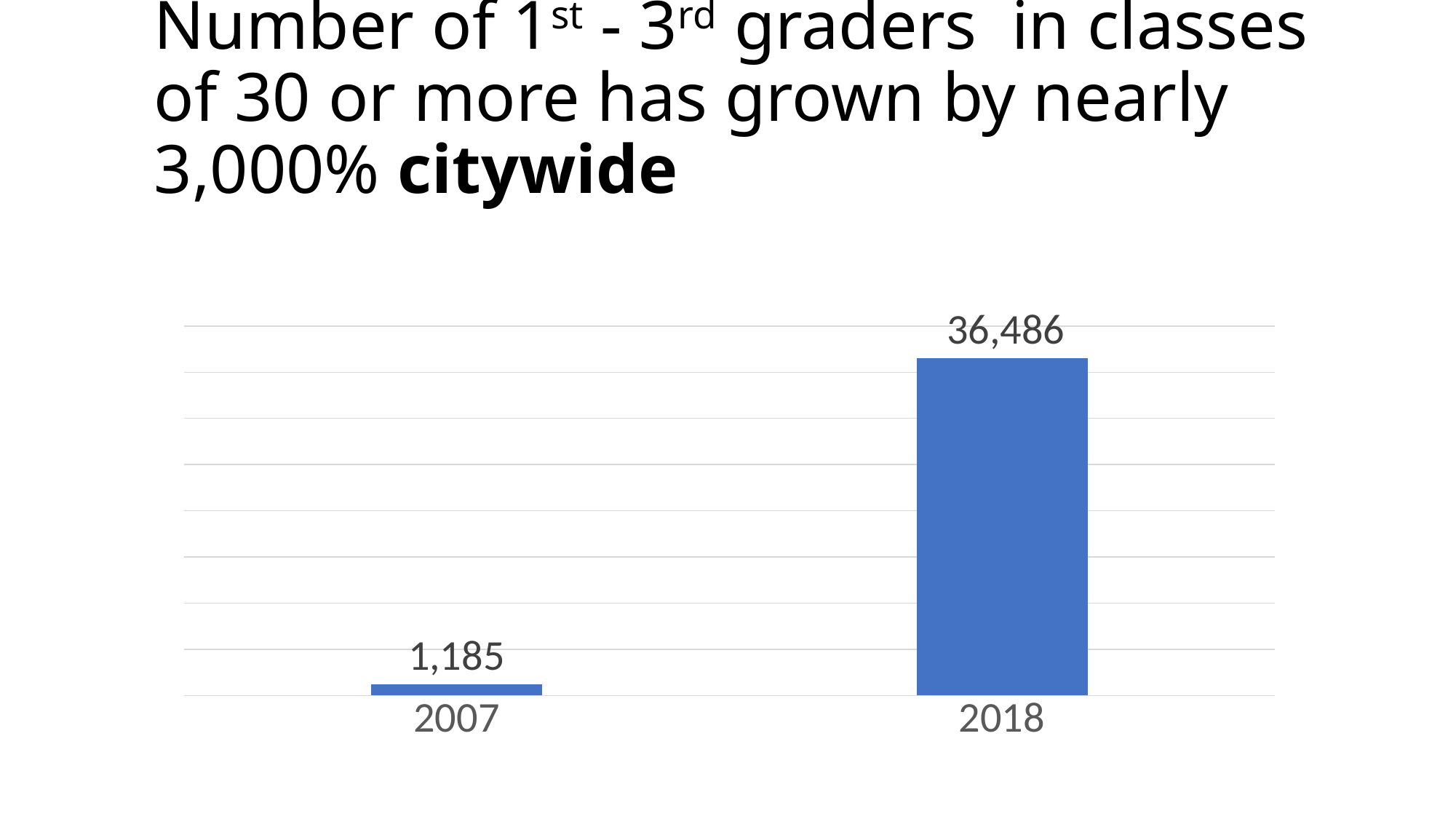
What is the difference between the values for 2018 and 2007? 35,301 What is the value for 2018? 36,486 How many categories are shown on the x axis? 2 According to the slide title, by roughly what percentage has the number of 1st-3rd graders in classes of 30 or more grown citywide? nearly 3,000% Which is larger, the value for 2007 or the value for 2018? 2018 What is the value for 2007? 1,185 What colour are the bars in the chart? blue What kind of chart is shown on the slide? bar chart Which year has the lowest value? 2007 Which year has the highest value? 2018 Do the values rise or fall from 2007 to 2018? rise